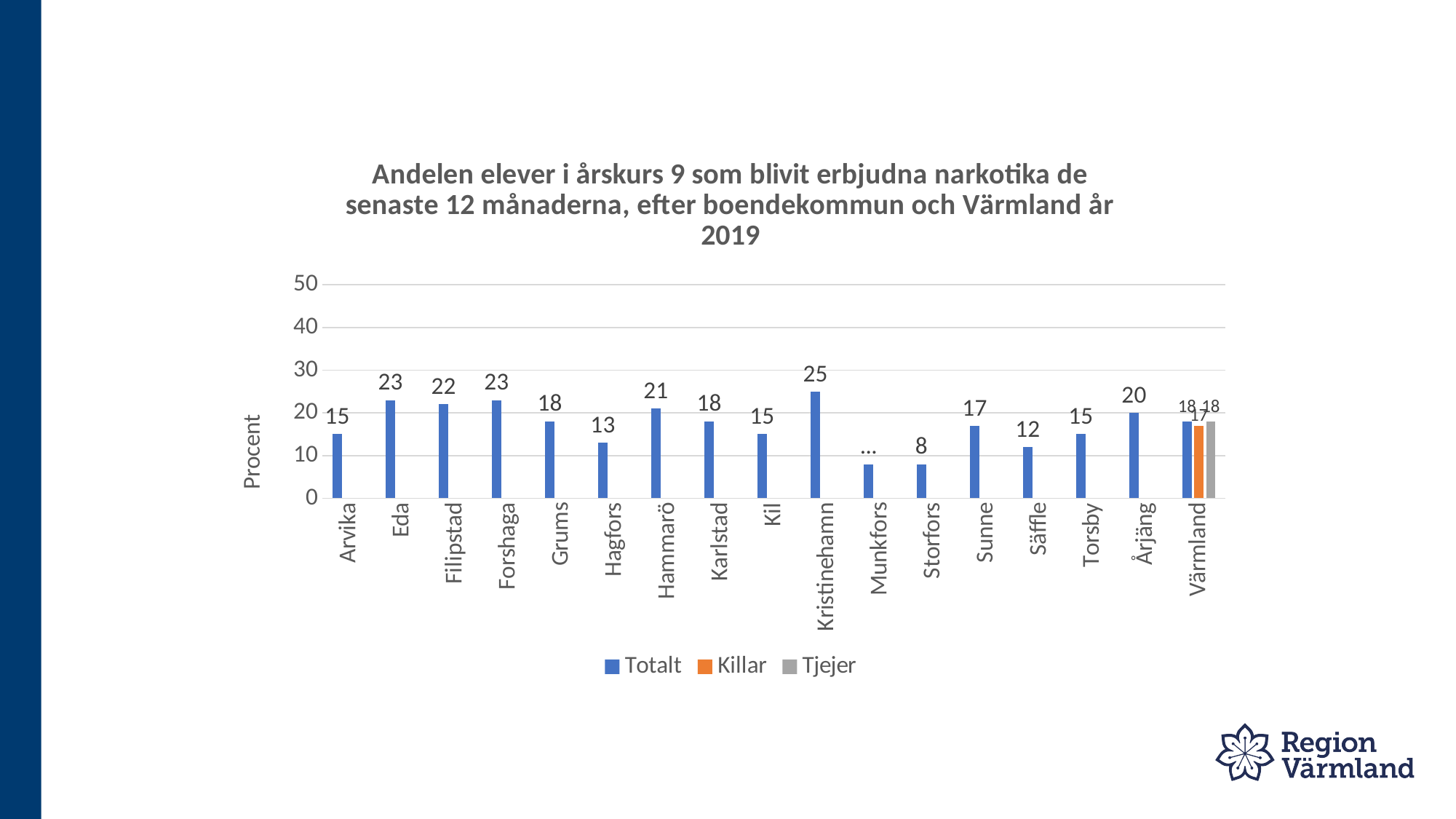
How many categories are shown on the x axis? 17 Is the value for Munkfors greater or less than 10? less How many series does the legend list? 3 What is the Killar value for Värmland? 17 Which series is shown in orange in the legend? Killar What kind of chart is shown on the slide? bar chart What is the Totalt value for Kristinehamn? 25 Which has a higher Totalt value, Hammarö or Sunne? Hammarö Which municipality has the highest Totalt value? Kristinehamn What is the Totalt value for Hagfors? 13 What is the label of the y axis? Procent What is the difference between the Totalt values for Eda and Storfors? 15